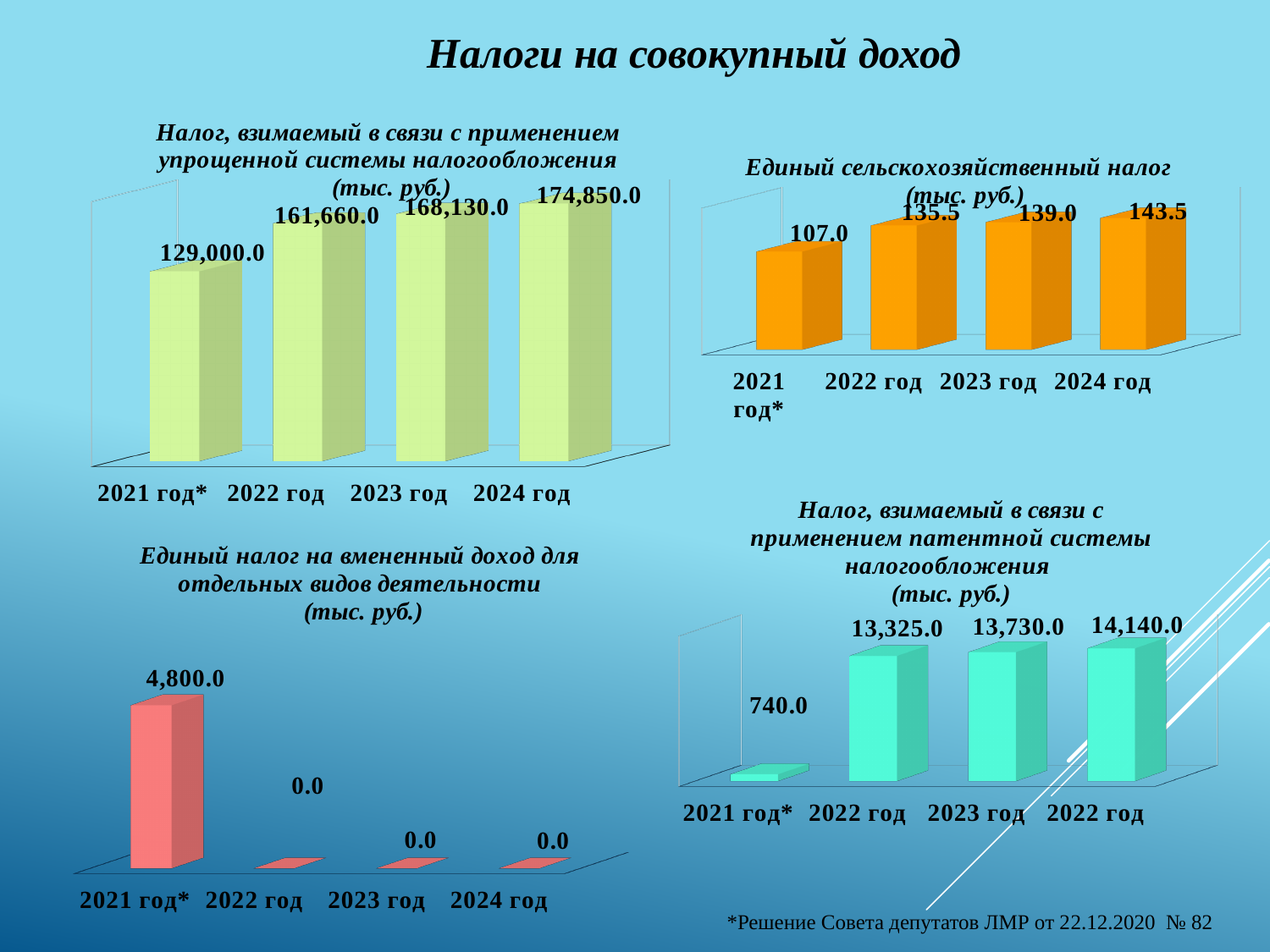
In the bottom-right chart (патентной системы налогообложения), what is the value for 2021 год*? 740.0 In the top-left chart (Налог, взимаемый в связи с применением упрощенной системы налогообложения), what is the value for 2021 год*? 129,000.0 How many bars does the bottom-right chart (патентной системы налогообложения) show? 4 In the top-right chart (Единый сельскохозяйственный налог), which year has the highest value? 2024 год In the bottom-left chart (Единый налог на вмененный доход), what is the value for 2021 год*? 4,800.0 In the top-right chart (Единый сельскохозяйственный налог), what is the value for 2022 год? 135.5 In the bottom-left chart (Единый налог на вмененный доход), what is the value for 2023 год? 0.0 In the top-left chart (упрощенной системы налогообложения), what is the value for 2024 год? 174,850.0 In the top-left chart (упрощенной системы налогообложения), do the values rise or fall from 2021 to 2024? rise In the top-right chart (Единый сельскохозяйственный налог), what is the difference between the values for 2024 год and 2023 год? 4.5 In the bottom-right chart (патентной системы налогообложения), which is larger: the value for 2023 год or the value for 2021 год*? 2023 год In the top-left chart (упрощенной системы налогообложения), what is the difference between the values for 2022 год and 2021 год*? 32,660.0